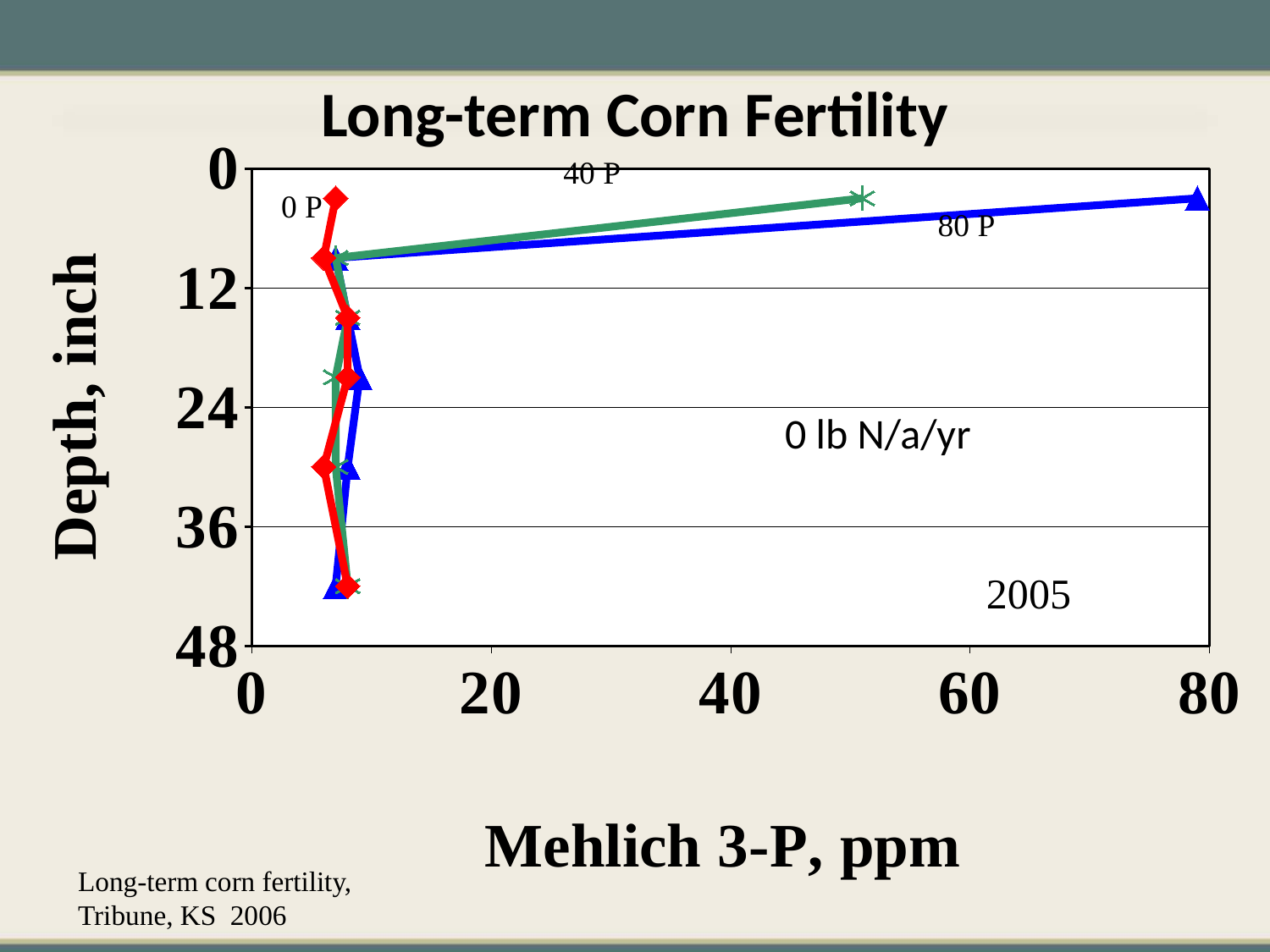
At the shallowest depth, which series has the higher Mehlich 3-P value, 40 P or 0 P? 40 P Which series has the lowest Mehlich 3-P value at the shallowest depth? 0 P Which series has the highest Mehlich 3-P value at the shallowest depth? 80 P Is the Mehlich 3-P value for the 0 P series at the shallowest depth greater or less than 20? less What is the title of the chart? Long-term Corn Fertility What kind of chart is shown on the slide? line chart At the shallowest depth, which series has the higher Mehlich 3-P value, 80 P or 40 P? 80 P Is the Mehlich 3-P value for the 80 P series at the shallowest depth greater or less than 60? greater Is the Mehlich 3-P value for the 40 P series at the shallowest depth greater or less than 40? greater What is the label of the horizontal axis? Mehlich 3-P, ppm How many series (P rates) are plotted on the chart? 3